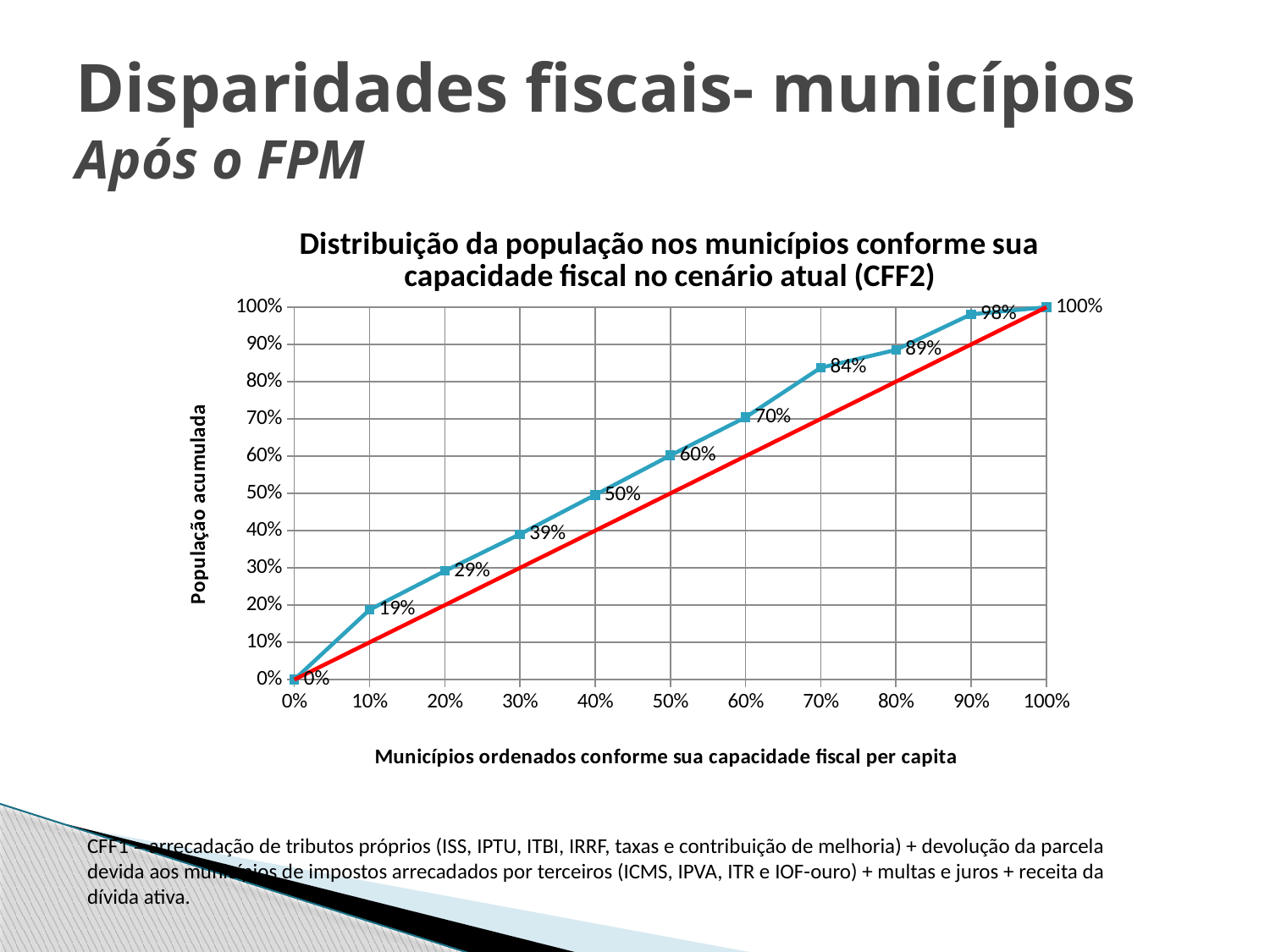
What is the accumulated population value at 10% of municipalities? 19% What is the accumulated population value at 70% of municipalities? 84% How many labelled data points does the blue line have? 11 What is the label of the y axis? População acumulada What is the difference between the accumulated population at 60% and at 50% of municipalities? 10% Does the accumulated population rise or fall as the share of municipalities increases along the x axis? Rises What is the difference between the accumulated population at 70% and at 60% of municipalities? 14% Which is larger: the accumulated population at 20% of municipalities or at 30%? 30% What is the accumulated population value at 40% of municipalities? 50% What is the title of the chart? Distribuição da população nos municípios conforme sua capacidade fiscal no cenário atual (CFF2) What kind of chart is shown on the slide? Line chart What is the accumulated population value at 90% of municipalities? 98%